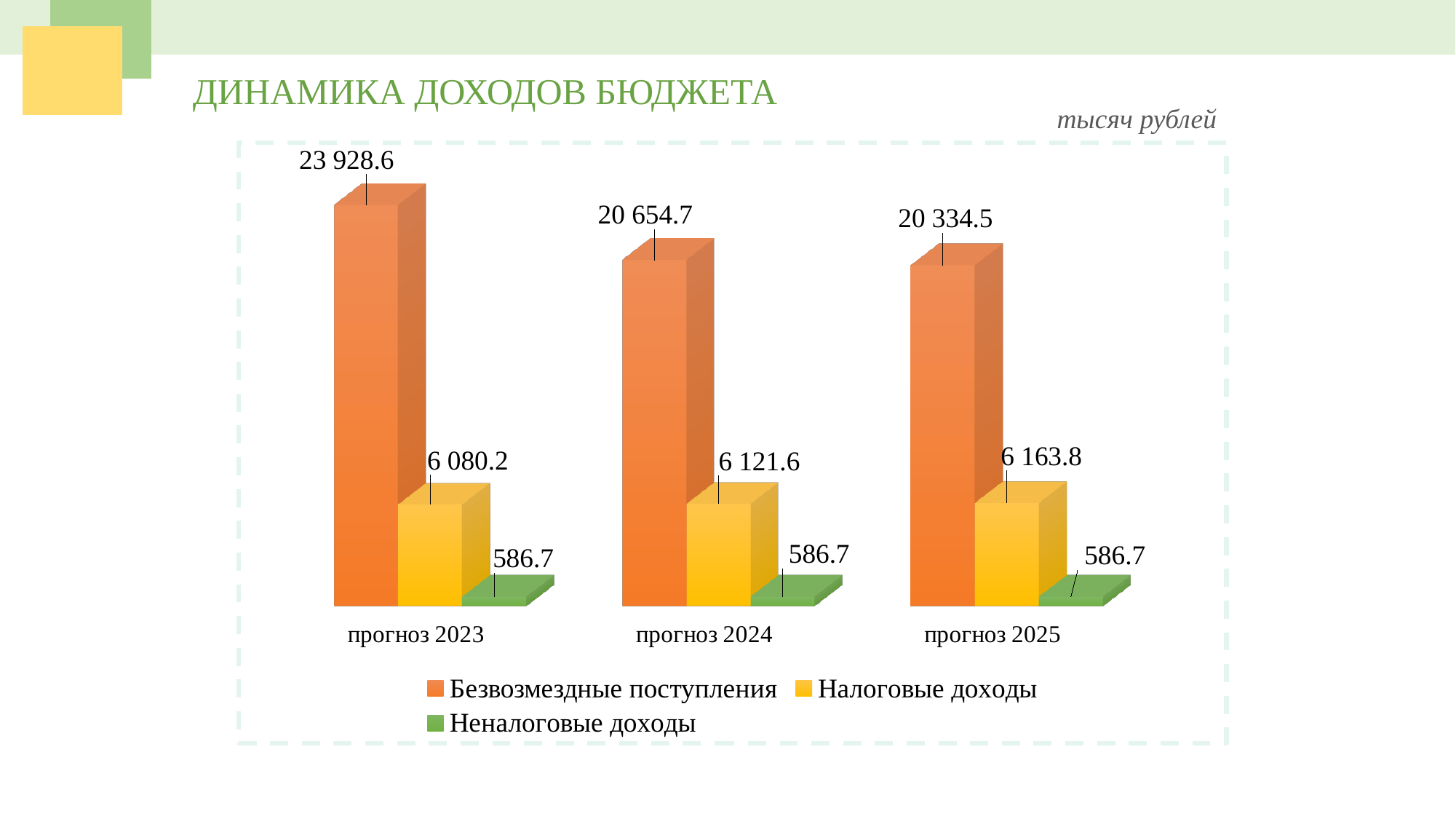
Do the values of Безвозмездные поступления rise or fall from прогноз 2023 to прогноз 2025? fall What kind of chart is shown on the slide? bar chart What is the difference between Налоговые доходы for прогноз 2025 and прогноз 2023? 83.6 What is the value of Безвозмездные поступления for прогноз 2023? 23 928.6 How many series does the legend list? 3 What is the value of Налоговые доходы for прогноз 2025? 6 163.8 In which forecast year is Налоговые доходы the lowest? прогноз 2023 In which forecast year is Безвозмездные поступления the highest? прогноз 2023 What is the difference between Безвозмездные поступления for прогноз 2023 and прогноз 2024? 3 273.9 Which is larger: Безвозмездные поступления for прогноз 2024 or for прогноз 2025? прогноз 2024 What is the value of Неналоговые доходы for прогноз 2024? 586.7 How many forecast years (categories) are shown on the x axis? 3